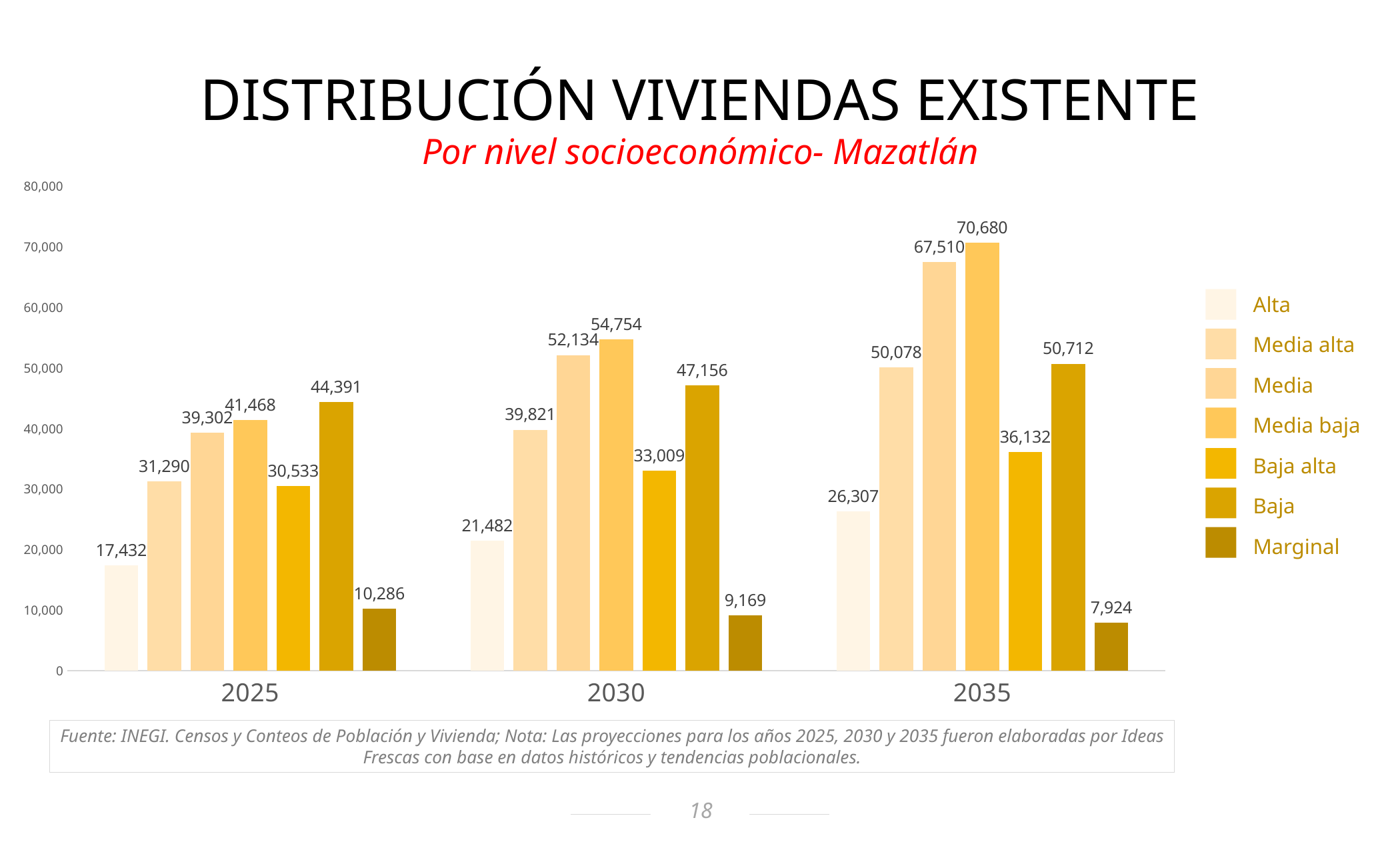
Which is larger in 2025: the Baja value or the Media baja value? Baja What is the difference between the Media value in 2035 and the Media value in 2025? 28,208 Does the value for Alta rise or fall from 2025 to 2035? rise What type of chart is shown on the slide? bar chart What is the value for Media baja in 2035? 70,680 How many series does the legend list? 7 What is the value for Baja alta in 2030? 33,009 What is the value for Marginal in 2025? 10,286 Which series has the lowest value in 2035? Marginal What is the red subtitle of the chart? Por nivel socioeconómico- Mazatlán How many year categories are shown on the x axis? 3 Which series has the highest value in 2030? Media baja